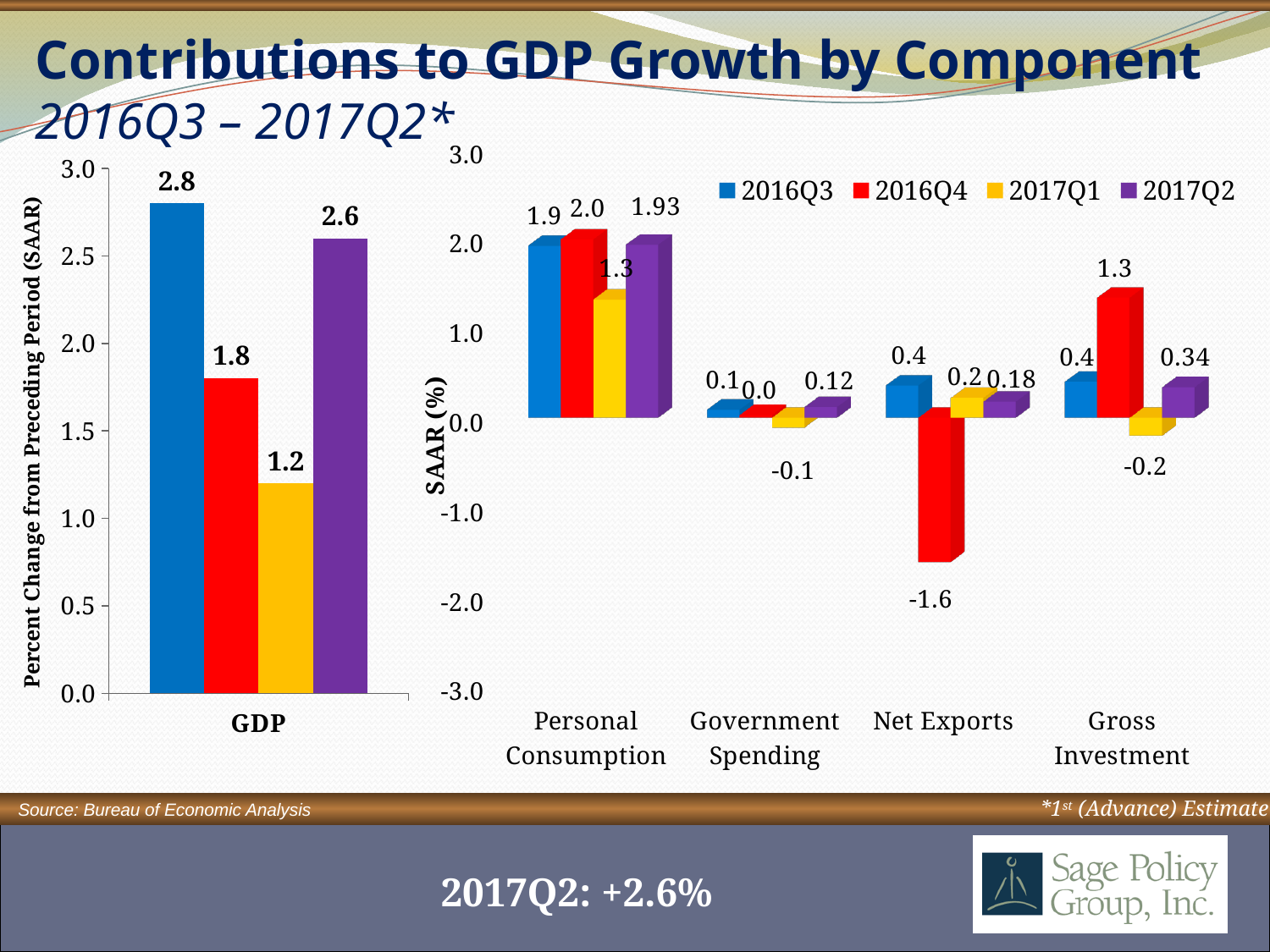
In the right chart (components), which is larger for Government Spending: the 2016Q3 value or the 2017Q2 value? 2017Q2 In the right chart (components), which quarter has the highest value for Gross Investment? 2016Q4 What type of chart is the left GDP chart? Bar chart In the left GDP chart, which quarter has the lowest value? 2017Q1 In the left GDP chart, how many bars are plotted? 4 In the left GDP chart, what is the difference between the 2016Q3 and 2017Q1 values? 1.6 In the right chart (components), what is the difference between the 2016Q4 and 2017Q1 values for Personal Consumption? 0.7 In the left GDP chart, what is the value for 2016Q3? 2.8 In the right chart (components), what is the 2016Q4 value for Net Exports? -1.6 In the right chart (components), what is the 2017Q2 value for Personal Consumption? 1.93 In the right chart (components), how many series does the legend list? 4 In the right chart (components), how many categories are shown on the x axis? 4